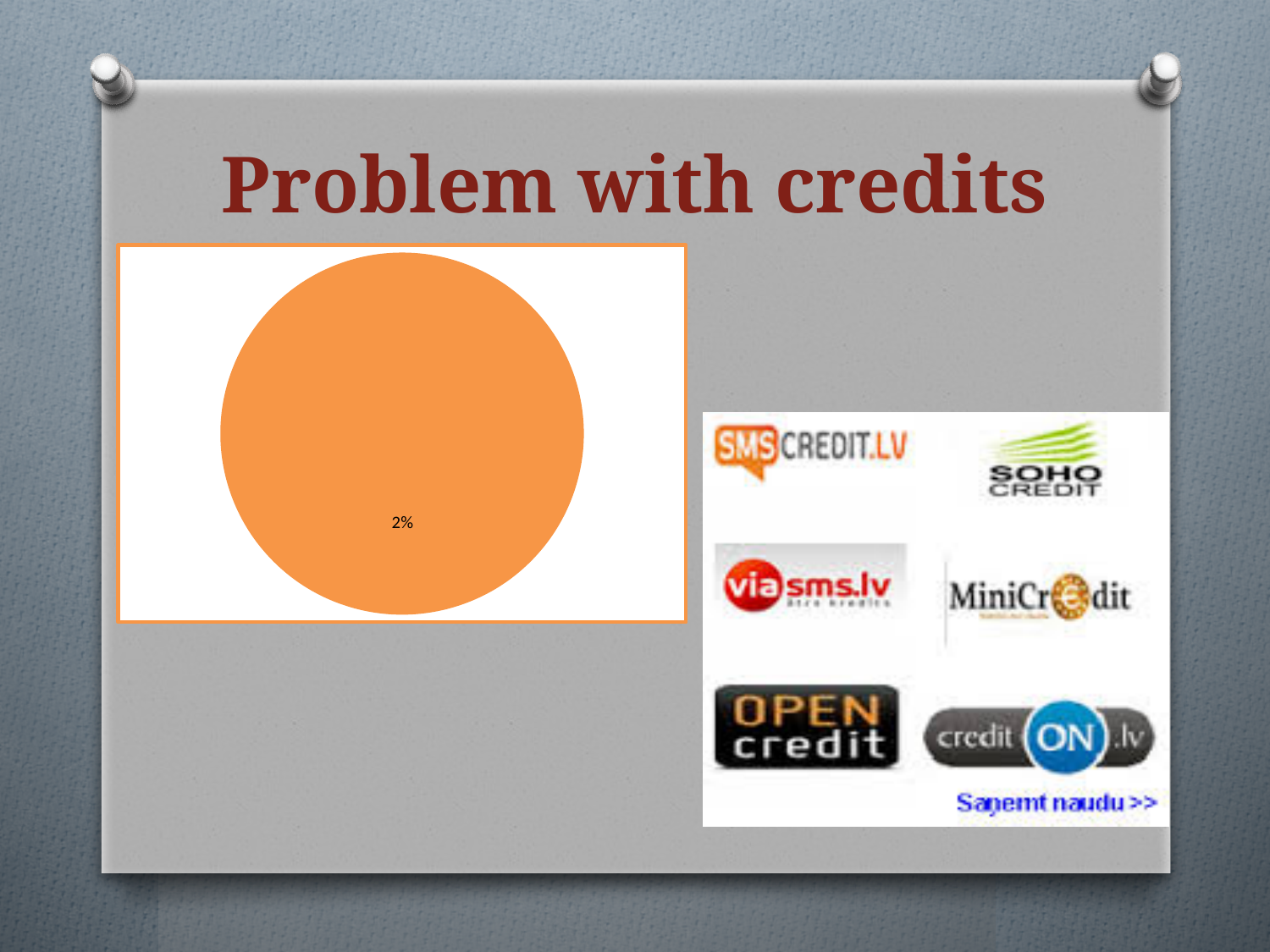
What kind of chart is shown on the slide? pie chart Does the pie chart display a legend? No How many slices are visible in the pie chart? 1 What data label is printed on the pie chart? 2% What colour is the slice in the pie chart? orange